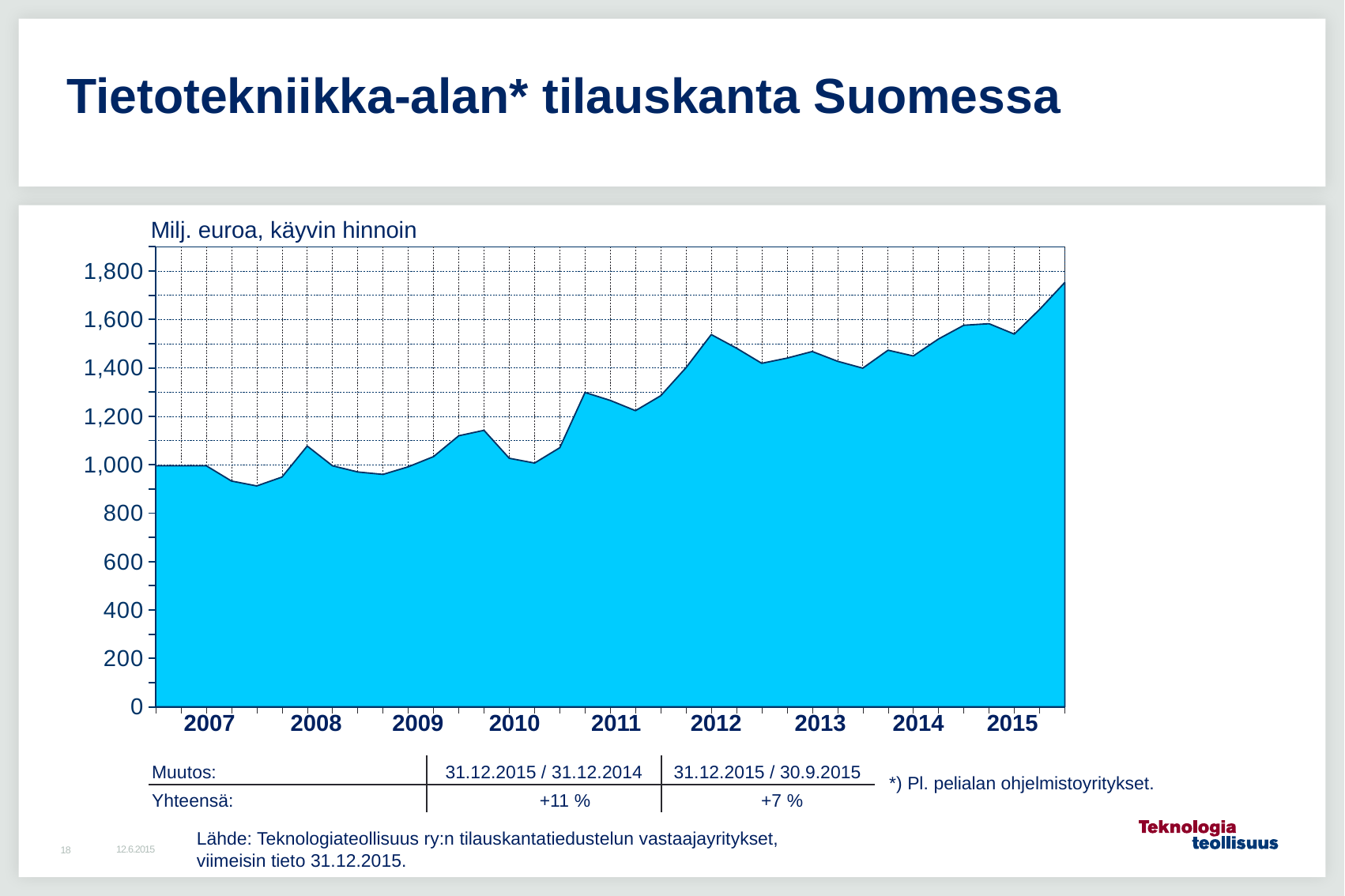
In which year does the chart reach its lowest value? 2007 Overall, do the values rise or fall from 2007 to 2015? rise In which year does the chart reach its highest value? 2015 Is the value at the end of 2015 larger than the value at the start of 2007? yes Is the value at the end of 2015 greater or less than 1,600? greater What is the title of the slide's chart? Tietotekniikka-alan* tilauskanta Suomessa According to the table below the chart, what is the change from 31.12.2014 to 31.12.2015? +11 % Is the value at the start of 2012 greater or less than 1,200? greater Is the value at the start of 2009 greater or less than 1,200? less How many years are labelled on the x axis of the chart? 9 What unit is given for the vertical axis of the chart? Milj. euroa, käyvin hinnoin What kind of chart is shown on the slide? area chart